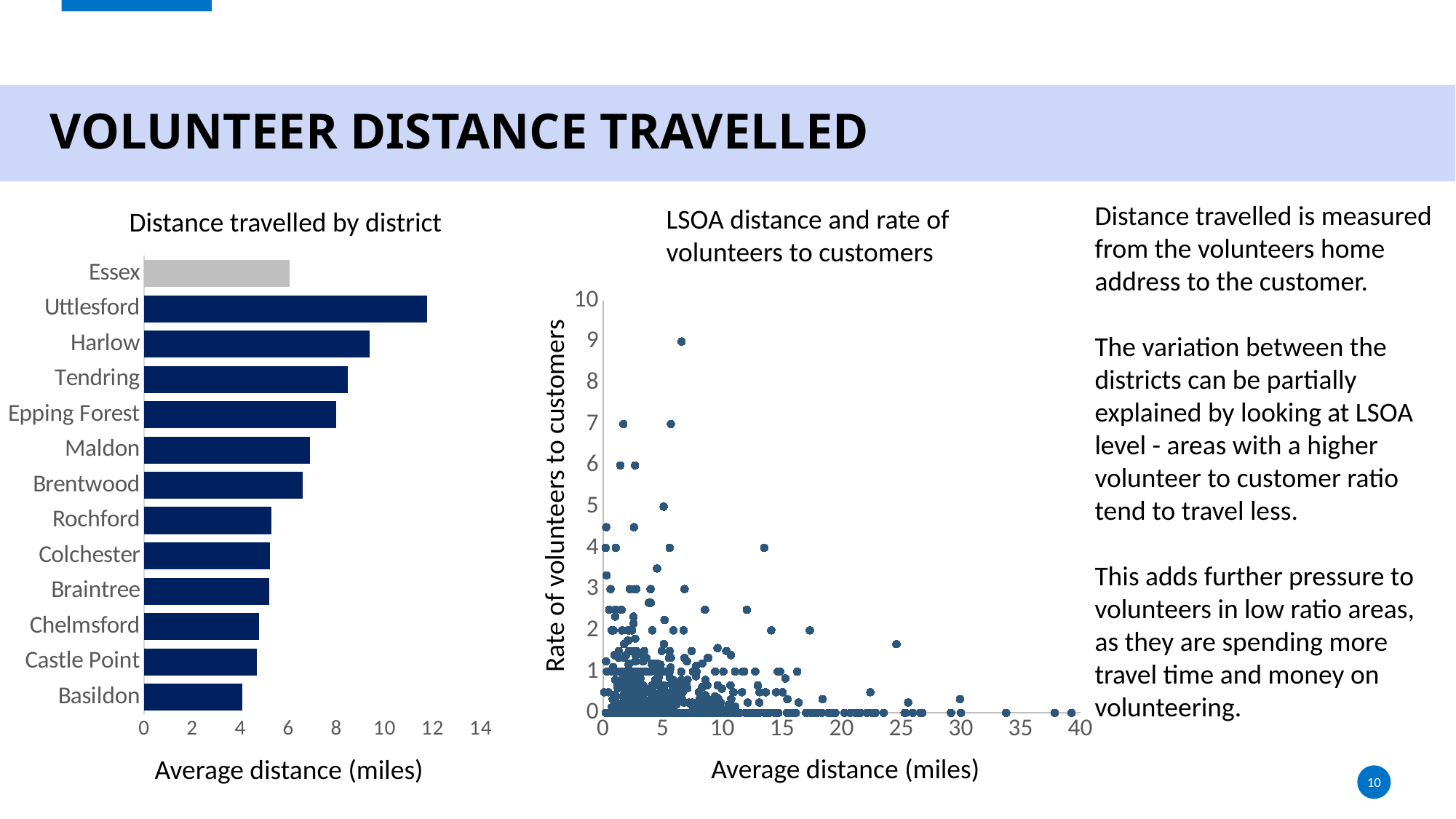
In 'Distance travelled by district', which district has the lowest average distance? Basildon In 'Distance travelled by district', which is larger, the value for Tendring or the value for Rochford? Tendring What is the y-axis title of 'LSOA distance and rate of volunteers to customers'? Rate of volunteers to customers What kind of chart is 'LSOA distance and rate of volunteers to customers'? scatter chart What is the x-axis title of 'Distance travelled by district'? Average distance (miles) In 'Distance travelled by district', is the value for Chelmsford greater or less than 6? less In 'Distance travelled by district', is the value for Harlow greater or less than 8? greater In 'Distance travelled by district', is the value for Uttlesford greater or less than 10? greater In 'Distance travelled by district', which district has the highest average distance? Uttlesford How many categories are shown in 'Distance travelled by district'? 13 In 'Distance travelled by district', which is larger, the value for Harlow or the value for Maldon? Harlow What kind of chart is 'Distance travelled by district'? bar chart